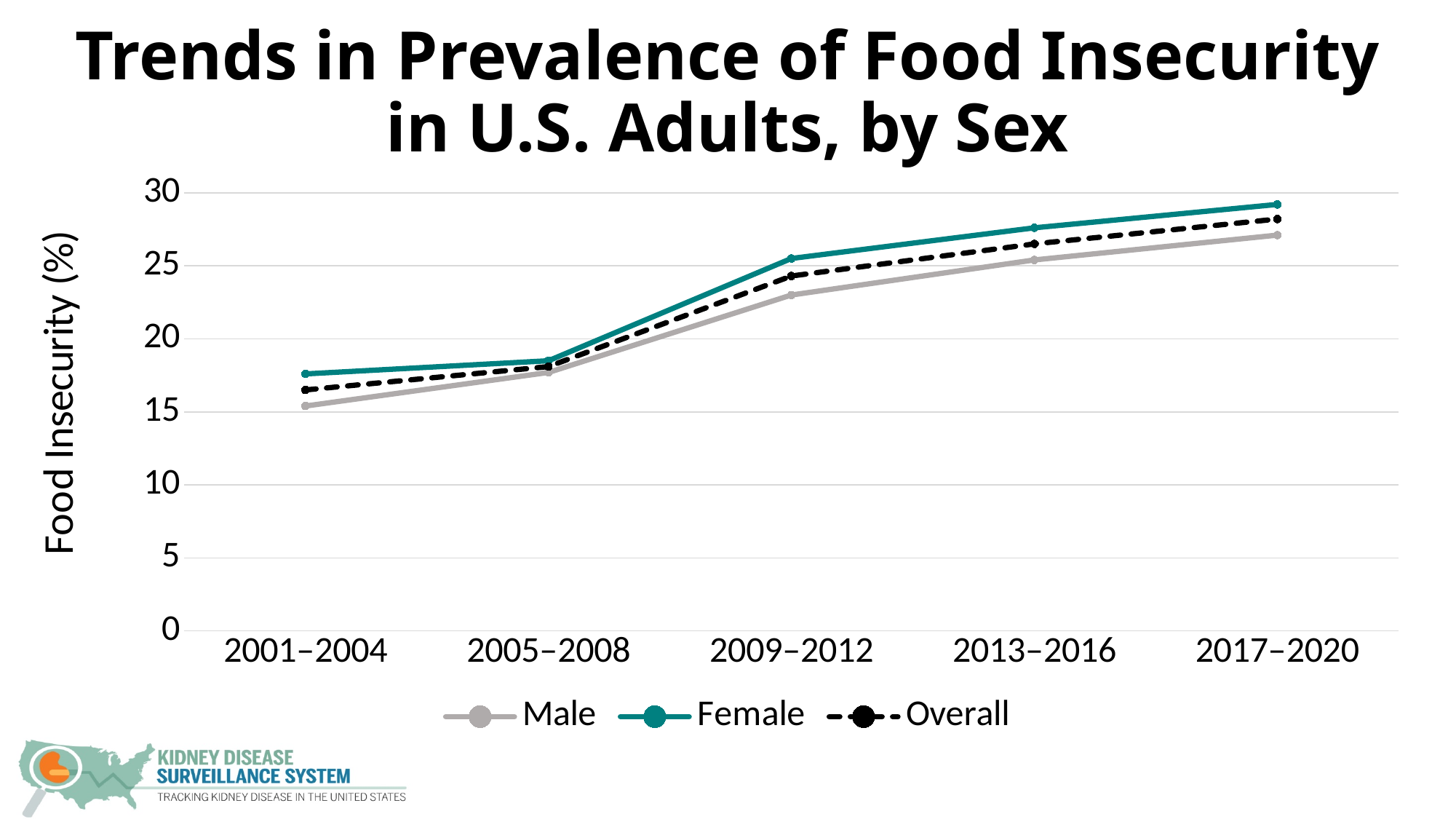
Is the Male value for 2001–2004 greater or less than 20? less Do the Female values rise or fall from 2001–2004 to 2017–2020? rise In which period is the Overall value lowest? 2001–2004 Which is larger in 2009–2012, the Male value or the Female value? Female Is the Overall value for 2009–2012 greater or less than 20? greater Is the Female value for 2017–2020 greater or less than 25? greater Which series is drawn with a dashed line? Overall What is the label of the y axis? Food Insecurity (%) What kind of chart is shown on the slide? line chart How many time periods are shown on the x axis? 5 How many series does the legend list? 3 In which period is the Male value highest? 2017–2020